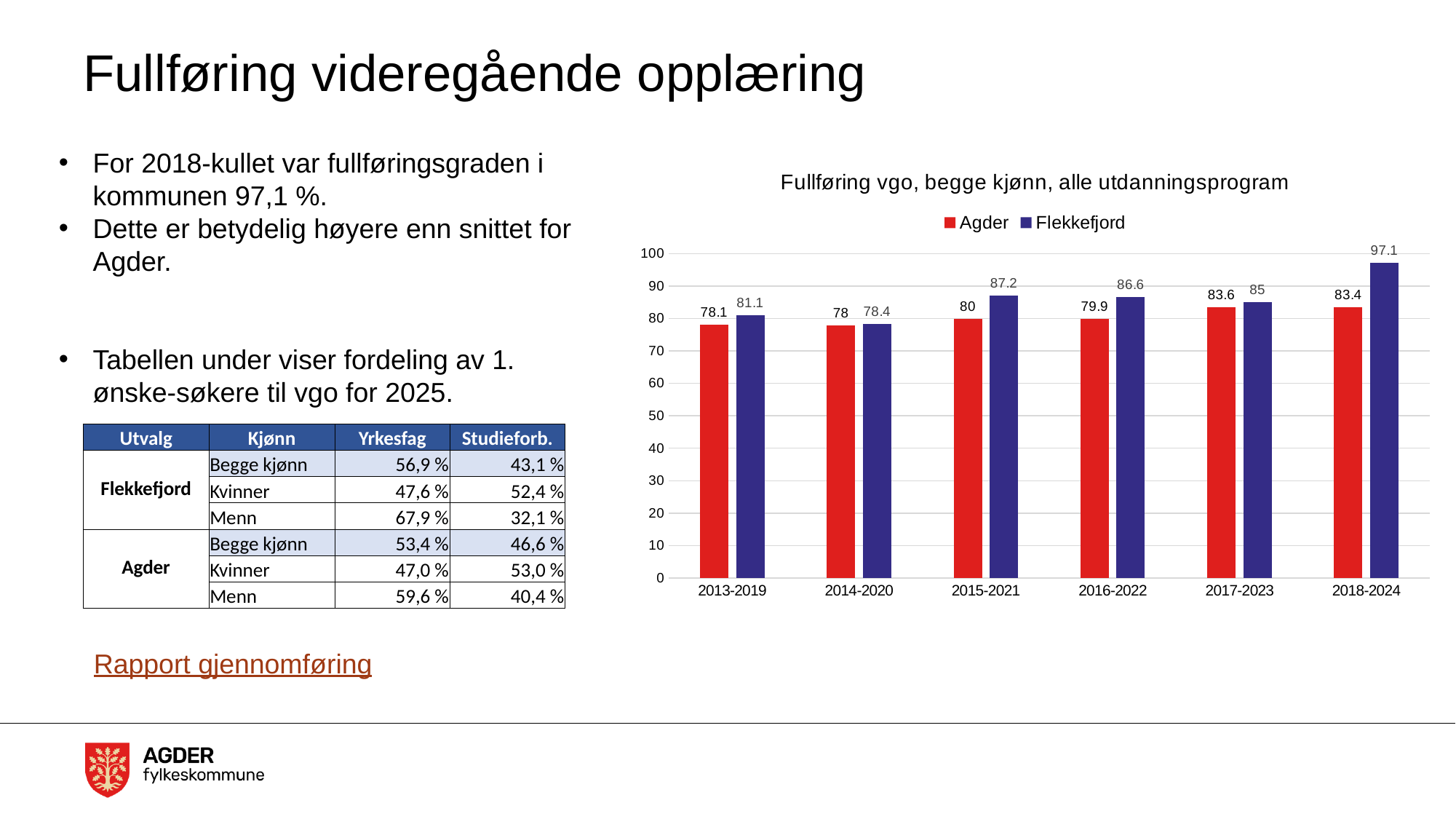
How many series does the legend list? 2 How many periods are shown on the x axis? 6 What is the value for Agder in 2014-2020? 78 Which is larger in 2015-2021, Agder or Flekkefjord? Flekkefjord Which period has the lowest value for Flekkefjord? 2014-2020 What is the difference between Flekkefjord and Agder in 2018-2024? 13.7 What is the difference between Flekkefjord and Agder in 2016-2022? 6.7 What is the value for Flekkefjord in 2015-2021? 87.2 What is the value for Flekkefjord in 2018-2024? 97.1 What kind of chart is shown? Bar chart What is the title of the chart? Fullføring vgo, begge kjønn, alle utdanningsprogram Which period has the highest value for Agder? 2017-2023